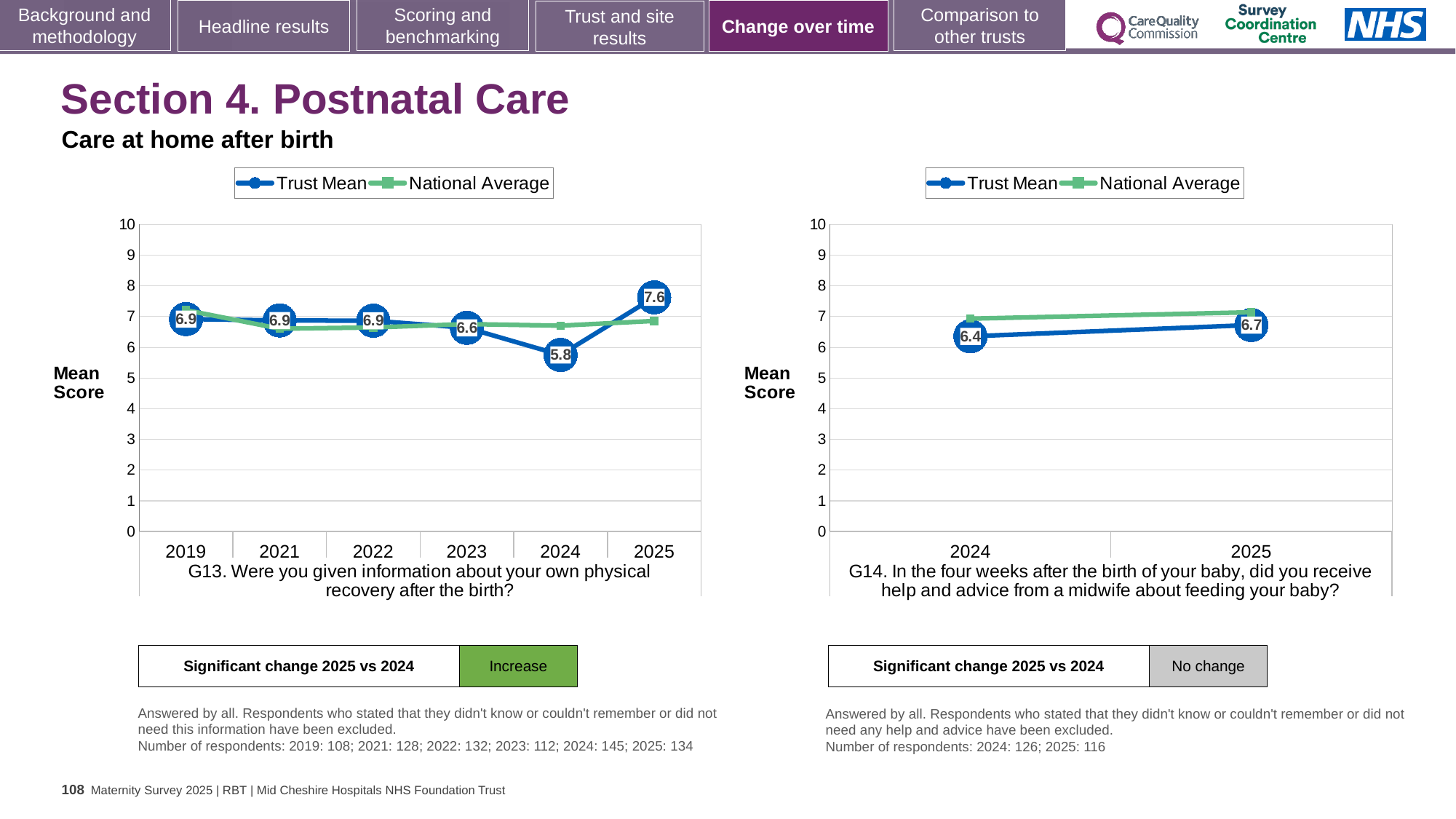
In the G14 chart, does the Trust Mean rise or fall from 2024 to 2025? rise How many series does the legend of the G13 chart list? 2 In the G13 chart, which year has the lowest Trust Mean score? 2024 In the G13 chart, how many years are plotted on the x axis? 6 In the G13 chart, what is the difference between the Trust Mean scores for 2025 and 2024? 1.8 In the G13 chart, which year has the highest Trust Mean score? 2025 In the G13 chart, what is the Trust Mean score for 2024? 5.8 In the G14 chart, is the National Average for 2024 greater or less than 6? greater In the G13 chart, what is the Trust Mean score for 2023? 6.6 In the G13 chart, what is the Trust Mean score for 2025? 7.6 In the G14 chart, what is the Trust Mean score for 2024? 6.4 In the G14 chart, what is the Trust Mean score for 2025? 6.7